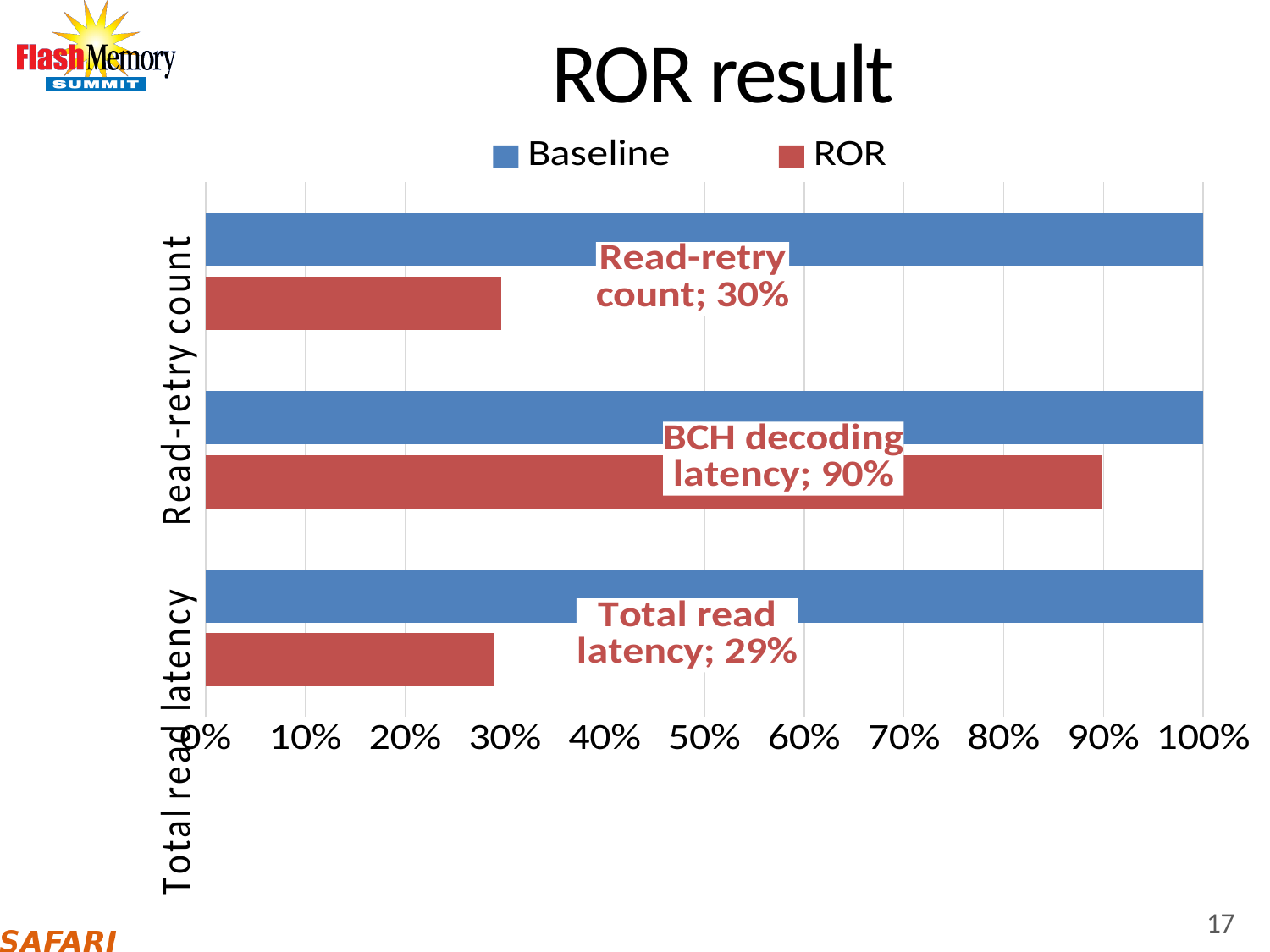
How many categories are plotted in the chart? 3 What is the difference between the Baseline and ROR values for BCH decoding latency? 10% How many series does the legend list? 2 What is the difference between the ROR values for BCH decoding latency and Read-retry count? 60% What is the ROR value for Read-retry count? 30% What are the two series named in the legend? Baseline and ROR What is the Baseline value for Read-retry count? 100% Which is larger, the ROR value for Read-retry count or the ROR value for BCH decoding latency? BCH decoding latency Which category has the highest ROR value? BCH decoding latency What is the ROR value for Total read latency? 29% What kind of chart is shown on the slide? bar chart What is the ROR value for BCH decoding latency? 90%